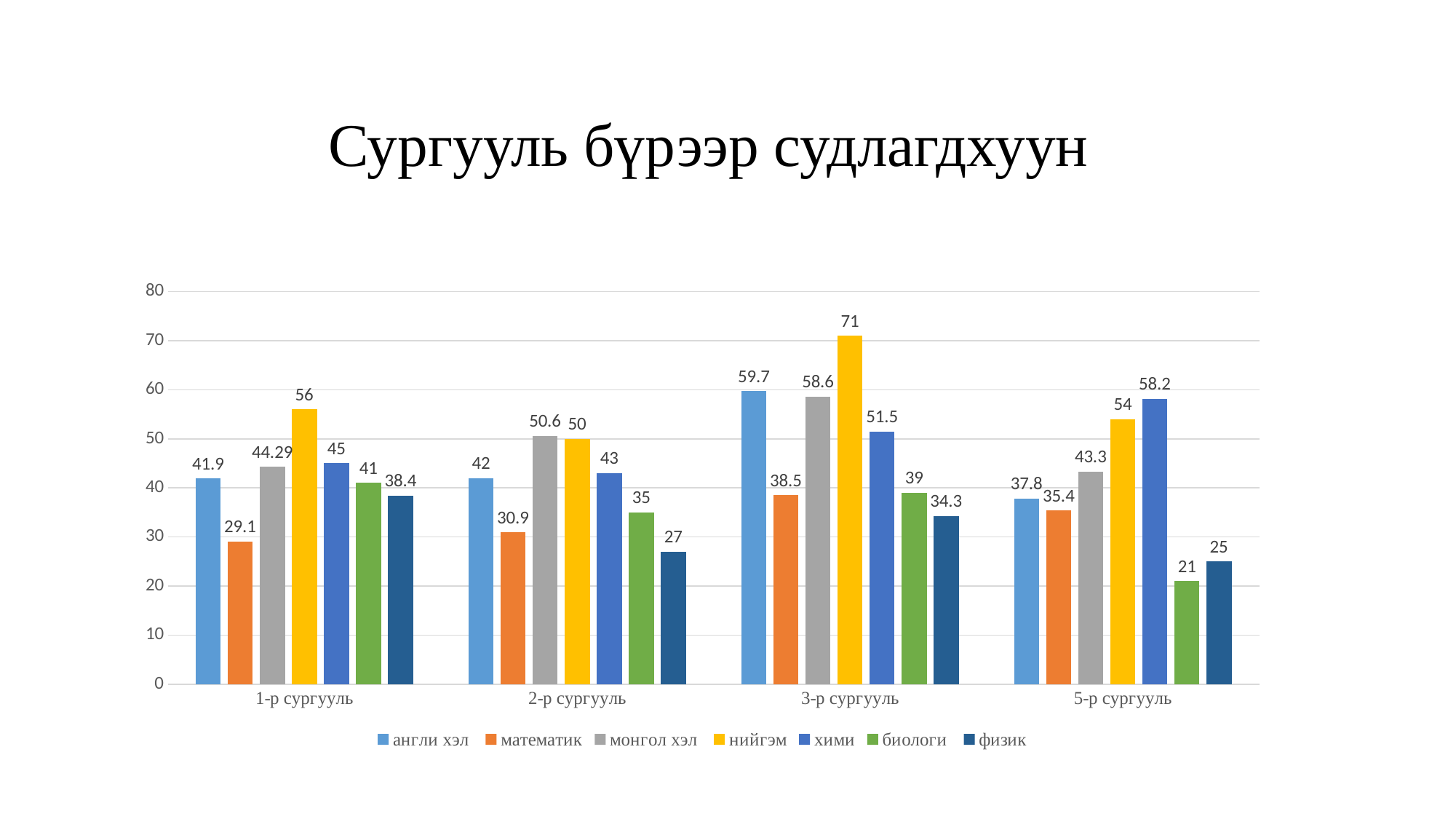
What is the value for математик at 1-р сургууль? 29.1 What is the value for нийгэм at 3-р сургууль? 71 Which series has the highest value at 5-р сургууль? хими What is the difference between the хими values for 5-р сургууль and 1-р сургууль? 13.2 What kind of chart is shown on the slide? bar chart How many series does the legend list? 7 What is the value for физик at 2-р сургууль? 27 Which school has the highest value for нийгэм? 3-р сургууль Which school has the lowest value for биологи? 5-р сургууль What is the title of the slide? Сургууль бүрээр судлагдхуун How many schools (categories) are shown on the x axis? 4 At 2-р сургууль, which is larger: монгол хэл or нийгэм? монгол хэл